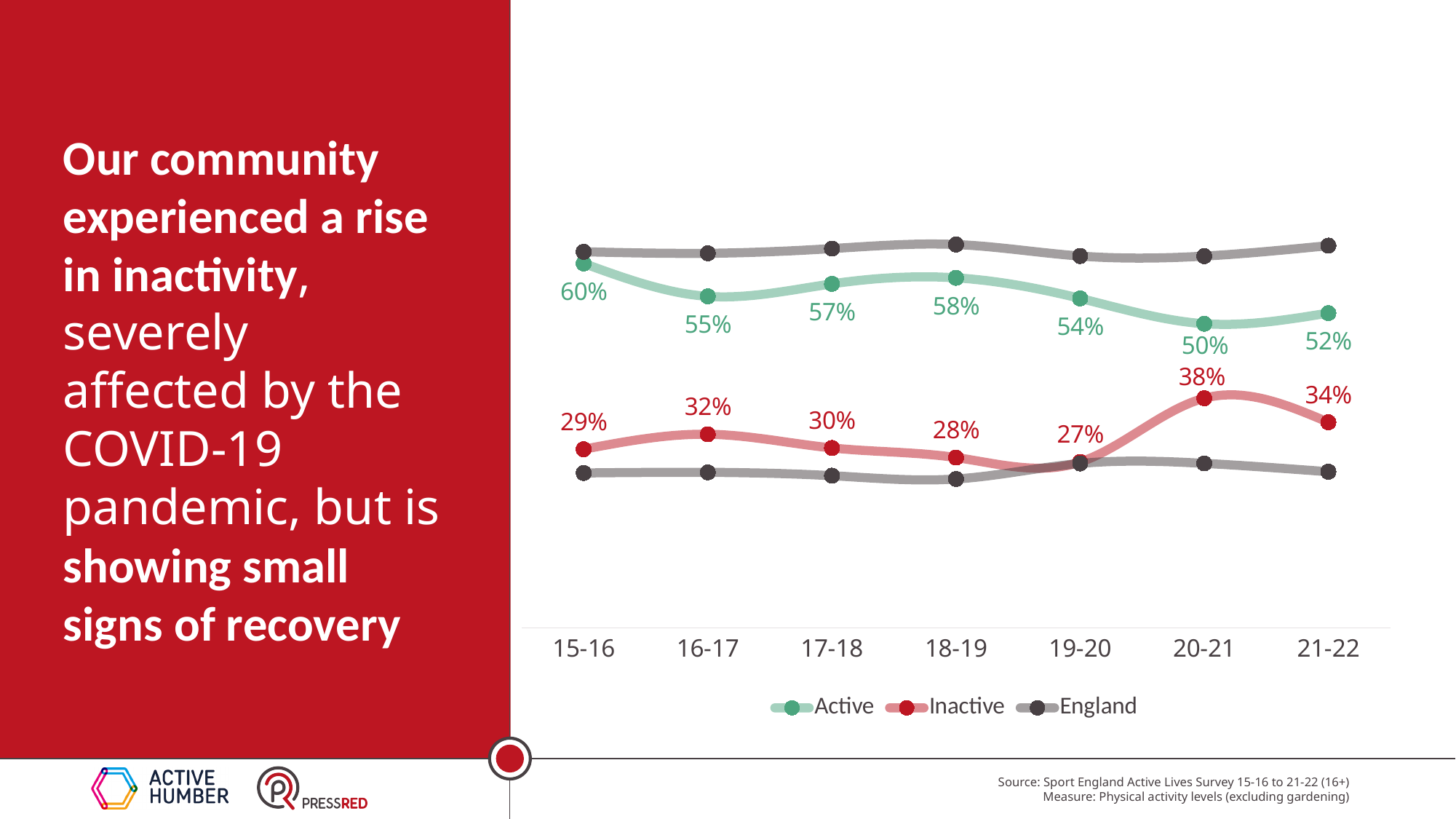
In which year is the Inactive value highest? 20-21 How many years are shown on the x axis? 7 How many series does the legend list? 3 What is the difference between the Active value in 15-16 and in 20-21? 10% What type of chart is shown on the slide? line chart What is the difference between the Inactive value in 20-21 and in 19-20? 11% What is the Active value for 21-22? 52% In which year is the Active value lowest? 20-21 What is the Inactive value for 19-20? 27% What is the Active value for 15-16? 60% Which is larger, the Inactive value in 16-17 or in 18-19? 16-17 What is the Inactive value for 20-21? 38%